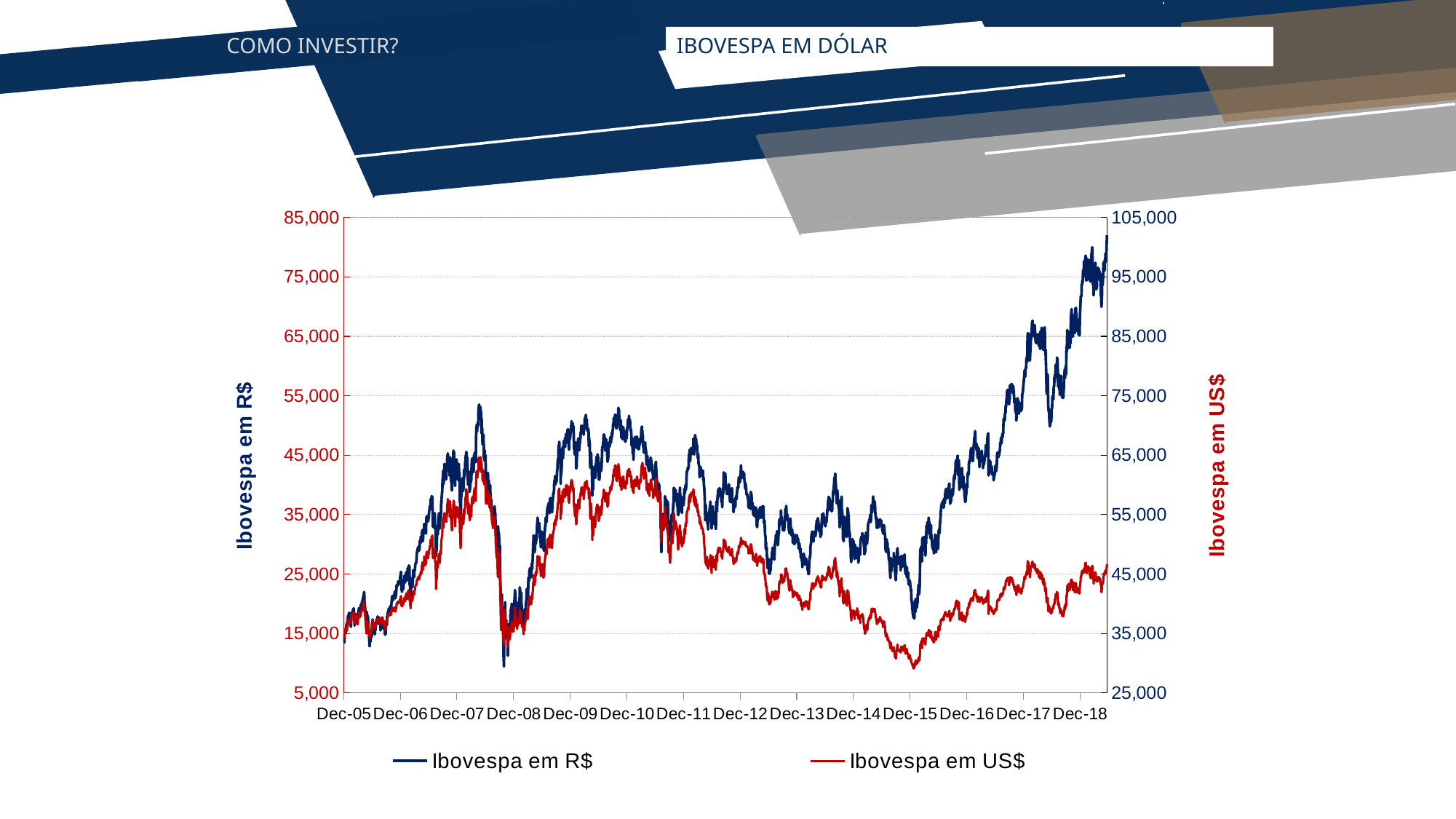
Is the value of Ibovespa em US$ at the end of the series (after Dec-18) greater or less than 55,000 on the right axis? less How many year labels are shown along the x axis? 14 Is the value of Ibovespa em US$ around Dec-15 greater or less than 35,000 on the right axis? less What colour is the Ibovespa em US$ line? red What kind of chart is shown on the slide? line chart What are the two series named in the legend? Ibovespa em R$ and Ibovespa em US$ Is the value of Ibovespa em R$ at the end of the series (after Dec-18) greater or less than 75,000? greater Does the Ibovespa em US$ line rise or fall between Dec-10 and Dec-15? fall How many series does the legend list? 2 Does the Ibovespa em R$ line rise or fall between Dec-15 and Dec-18? rise